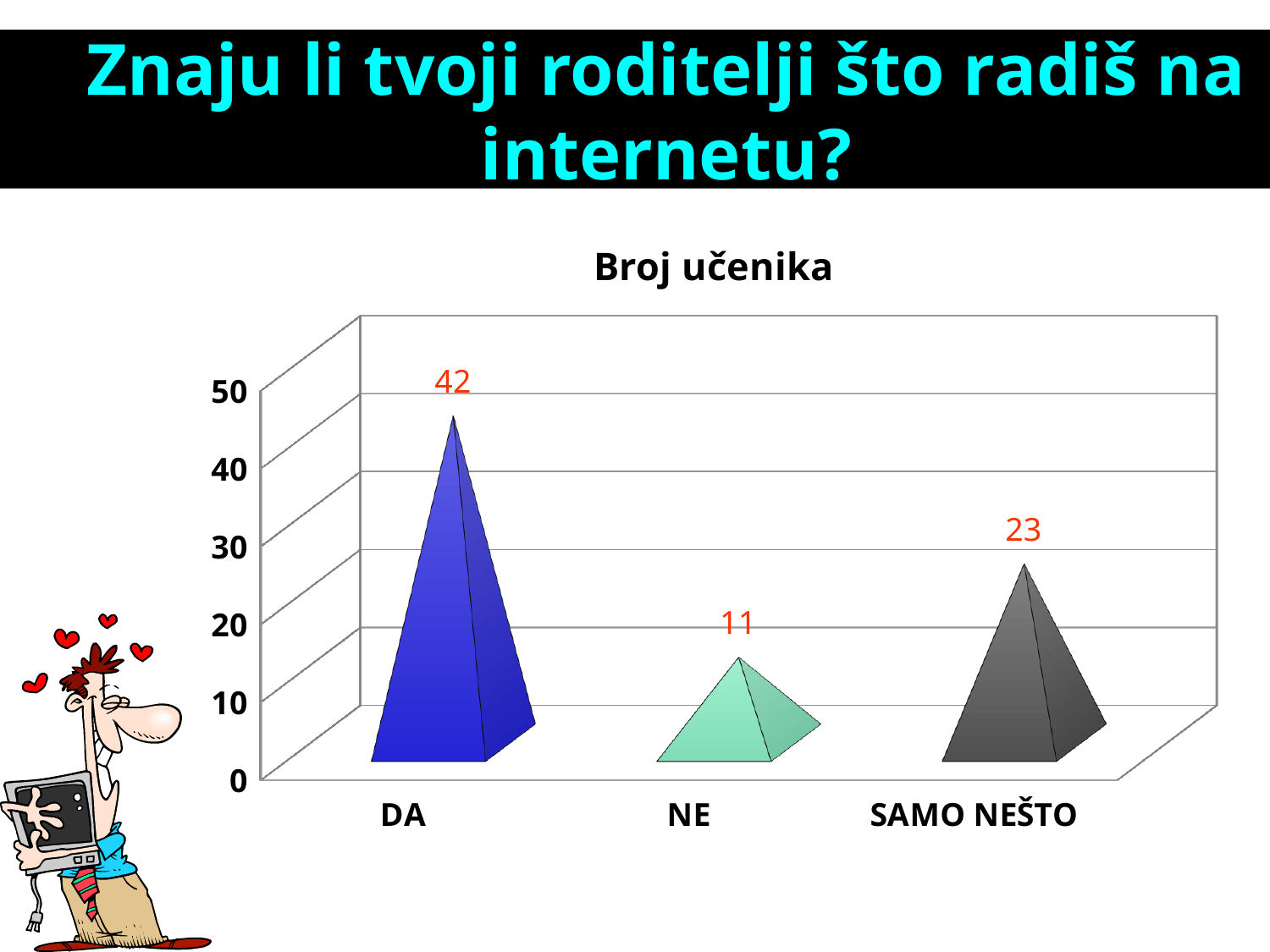
Is the value for DA greater or less than 40? greater What is the title of the chart? Broj učenika What is the value for SAMO NEŠTO? 23 What is the value for DA? 42 What kind of chart is shown on the slide? bar chart What is the difference between the values for SAMO NEŠTO and NE? 12 Which category has the lowest value? NE What is the difference between the values for DA and SAMO NEŠTO? 19 Which is larger, the value for NE or the value for SAMO NEŠTO? SAMO NEŠTO What is the value for NE? 11 How many categories are shown on the x axis? 3 Which category has the highest value? DA